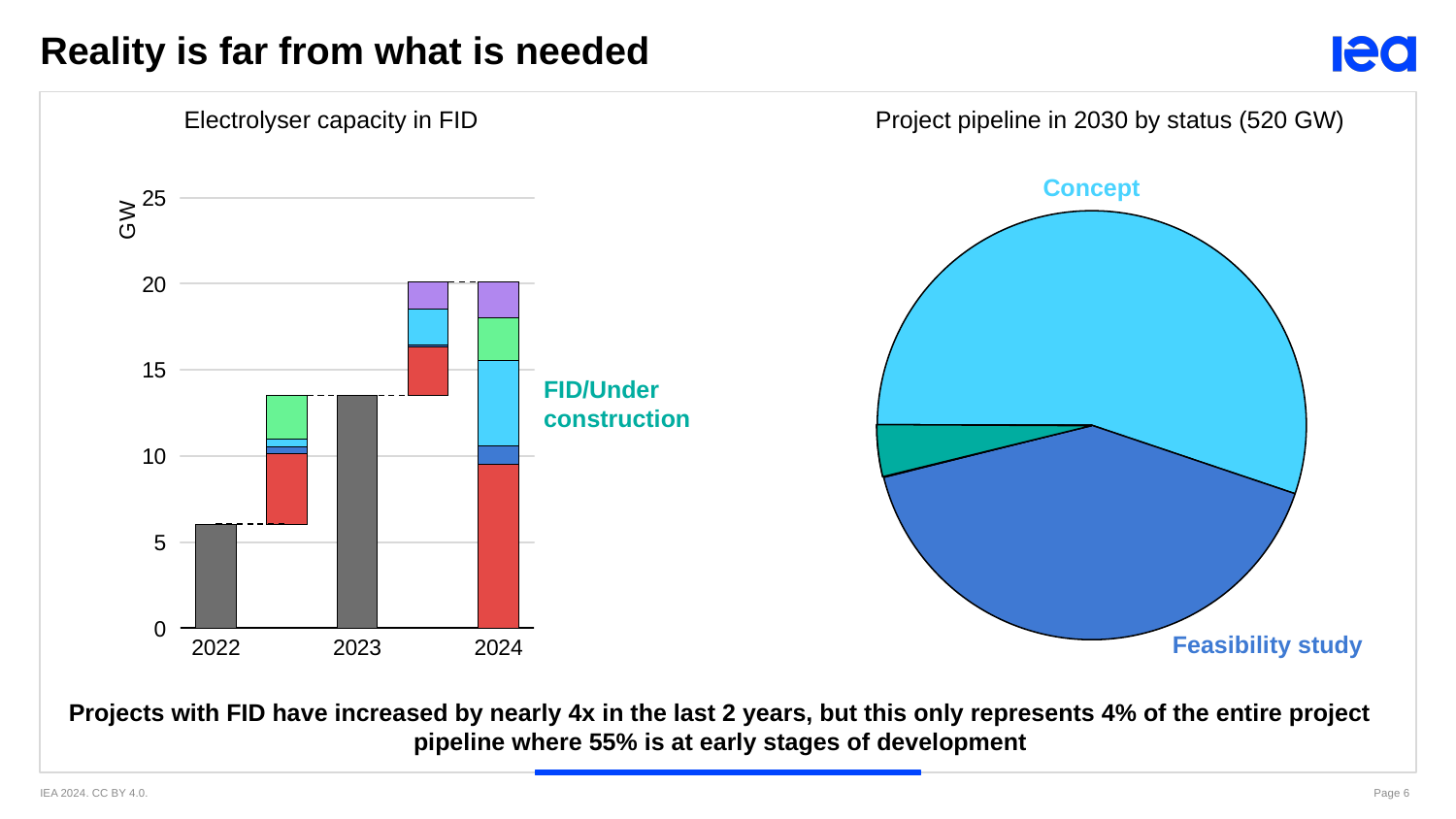
What kind of chart is the 'Electrolyser capacity in FID' chart on the left? bar chart In the 'Electrolyser capacity in FID' chart, which year has the highest total capacity? 2024 In the 'Project pipeline in 2030 by status' pie chart, which status has the smallest slice? FID/Under construction In the 'Electrolyser capacity in FID' chart, is the total for 2024 greater or less than 15 GW? greater In the 'Electrolyser capacity in FID' chart, do the values rise or fall from 2022 to 2024? rise In the 'Project pipeline in 2030 by status' pie chart, how many slices are there? 3 In the 'Electrolyser capacity in FID' chart, is the value for 2023 greater or less than 10 GW? greater In the 'Electrolyser capacity in FID' chart, is the value for 2022 greater or less than 10 GW? less In the 'Electrolyser capacity in FID' chart, how many years are shown on the x axis? 3 In the 'Electrolyser capacity in FID' chart, which year has the lowest capacity? 2022 In the 'Project pipeline in 2030 by status' pie chart, which status has the largest slice? Concept What kind of chart is the 'Project pipeline in 2030 by status' chart on the right? pie chart